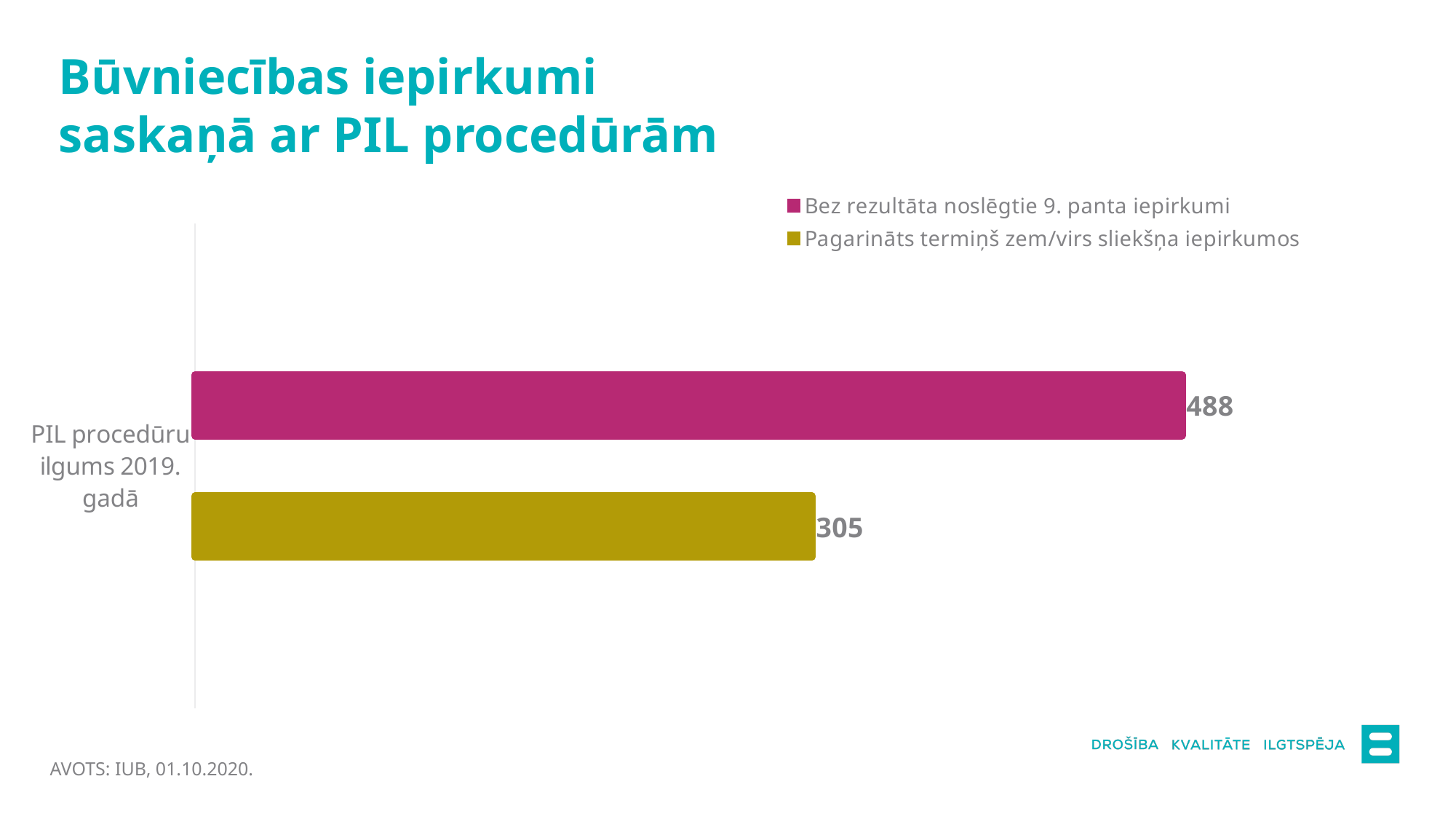
How many categories are shown on the category axis? 1 Which series has the higher value? Bez rezultāta noslēgtie 9. panta iepirkumi What is the category label on the chart's axis? PIL procedūru ilgums 2019. gadā What colour is the bar for "Pagarināts termiņš zem/virs sliekšņa iepirkumos"? olive/yellow-green What is the difference between the values for "Bez rezultāta noslēgtie 9. panta iepirkumi" and "Pagarināts termiņš zem/virs sliekšņa iepirkumos"? 183 What is the value for "Pagarināts termiņš zem/virs sliekšņa iepirkumos"? 305 What is the value for "Bez rezultāta noslēgtie 9. panta iepirkumi"? 488 What kind of chart is shown on the slide? bar chart How many series does the legend list? 2 Which series has the lower value? Pagarināts termiņš zem/virs sliekšņa iepirkumos Is the value for "Bez rezultāta noslēgtie 9. panta iepirkumi" larger or smaller than the value for "Pagarināts termiņš zem/virs sliekšņa iepirkumos"? larger